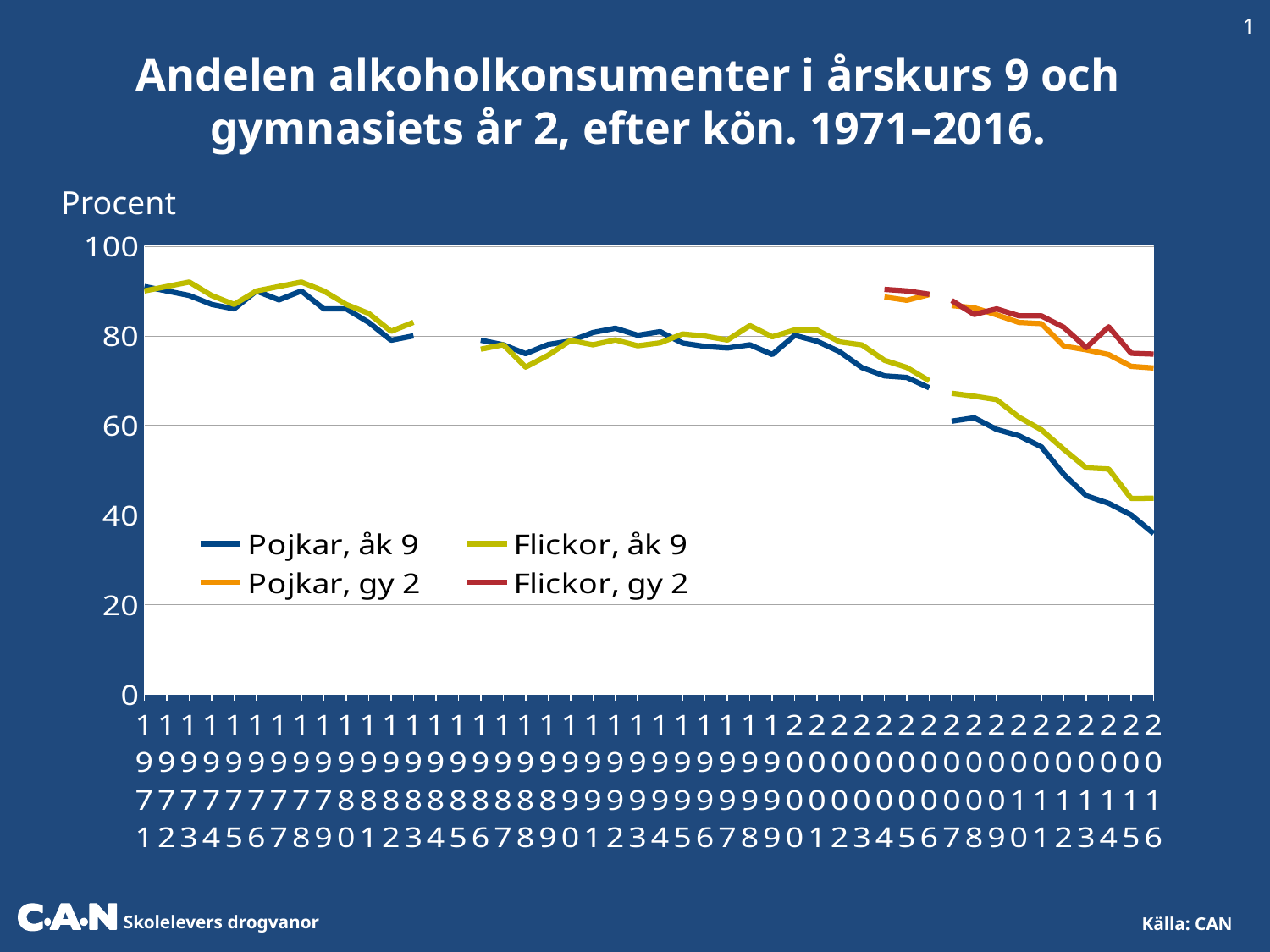
Which series has the lowest value in 2016? Pojkar, åk 9 Is the value for Flickor, åk 9 in 2016 greater or less than 40? greater Is the value for Flickor, gy 2 in 2004 greater or less than 80? greater Which series are listed in the legend? Pojkar, åk 9; Flickor, åk 9; Pojkar, gy 2; Flickor, gy 2 What is the label shown above the vertical axis? Procent Is the value for Pojkar, åk 9 in 1971 greater or less than 80? greater What kind of chart is shown on the slide? line chart In 2016, which is higher: Pojkar, åk 9 or Flickor, åk 9? Flickor, åk 9 Does the Pojkar, åk 9 series generally rise or fall from 1971 to 2016? fall How many series does the legend list? 4